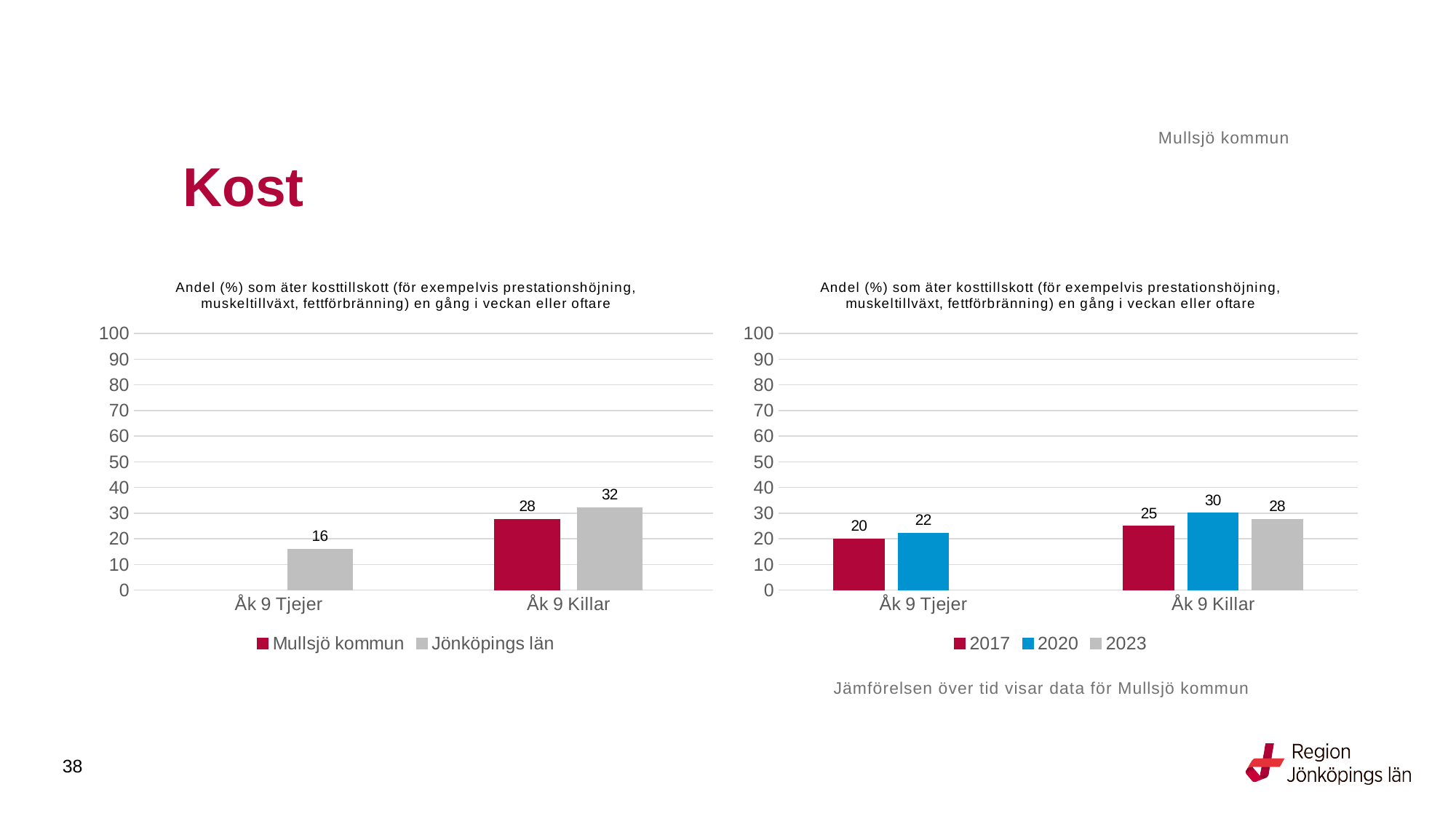
In the right chart, which year has the highest value for Åk 9 Killar? 2020 In the left chart, what is the value for Mullsjö kommun for Åk 9 Killar? 28 In the left chart, what is the value for Jönköpings län for Åk 9 Tjejer? 16 In the left chart, what is the difference between Jönköpings län and Mullsjö kommun for Åk 9 Killar? 4 In the right chart, what is the value for 2017 for Åk 9 Tjejer? 20 In the left chart, how many series does the legend list? 2 What kind of chart is the right chart? Bar chart In the left chart, what is the value for Jönköpings län for Åk 9 Killar? 32 In the right chart, what is the value for 2020 for Åk 9 Killar? 30 In the right chart, what is the value for 2023 for Åk 9 Killar? 28 In the right chart, how many series does the legend list? 3 In the right chart, what is the difference between the 2020 and 2017 values for Åk 9 Killar? 5